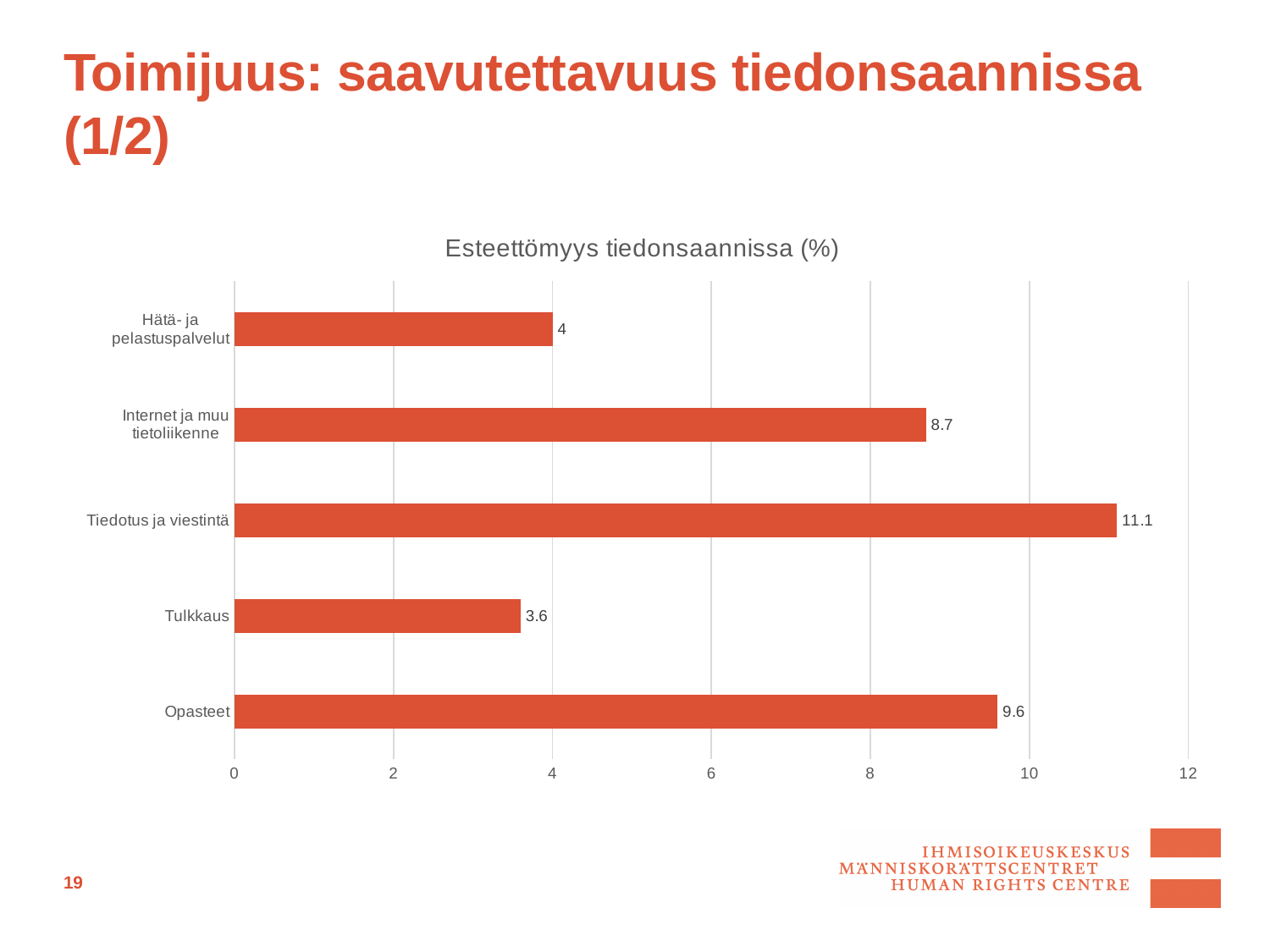
What is the value for Tulkkaus? 3.6 Which category has the highest value? Tiedotus ja viestintä What is the title of the chart? Esteettömyys tiedonsaannissa (%) What is the value for Opasteet? 9.6 What kind of chart is shown on the slide? bar chart How many categories are shown in the chart? 5 Is the value for Internet ja muu tietoliikenne greater or less than 8? greater Which is larger, the value for Opasteet or the value for Internet ja muu tietoliikenne? Opasteet What is the value for Hätä- ja pelastuspalvelut? 4 What is the value for Tiedotus ja viestintä? 11.1 Which category has the lowest value? Tulkkaus What is the difference between the values for Tiedotus ja viestintä and Internet ja muu tietoliikenne? 2.4